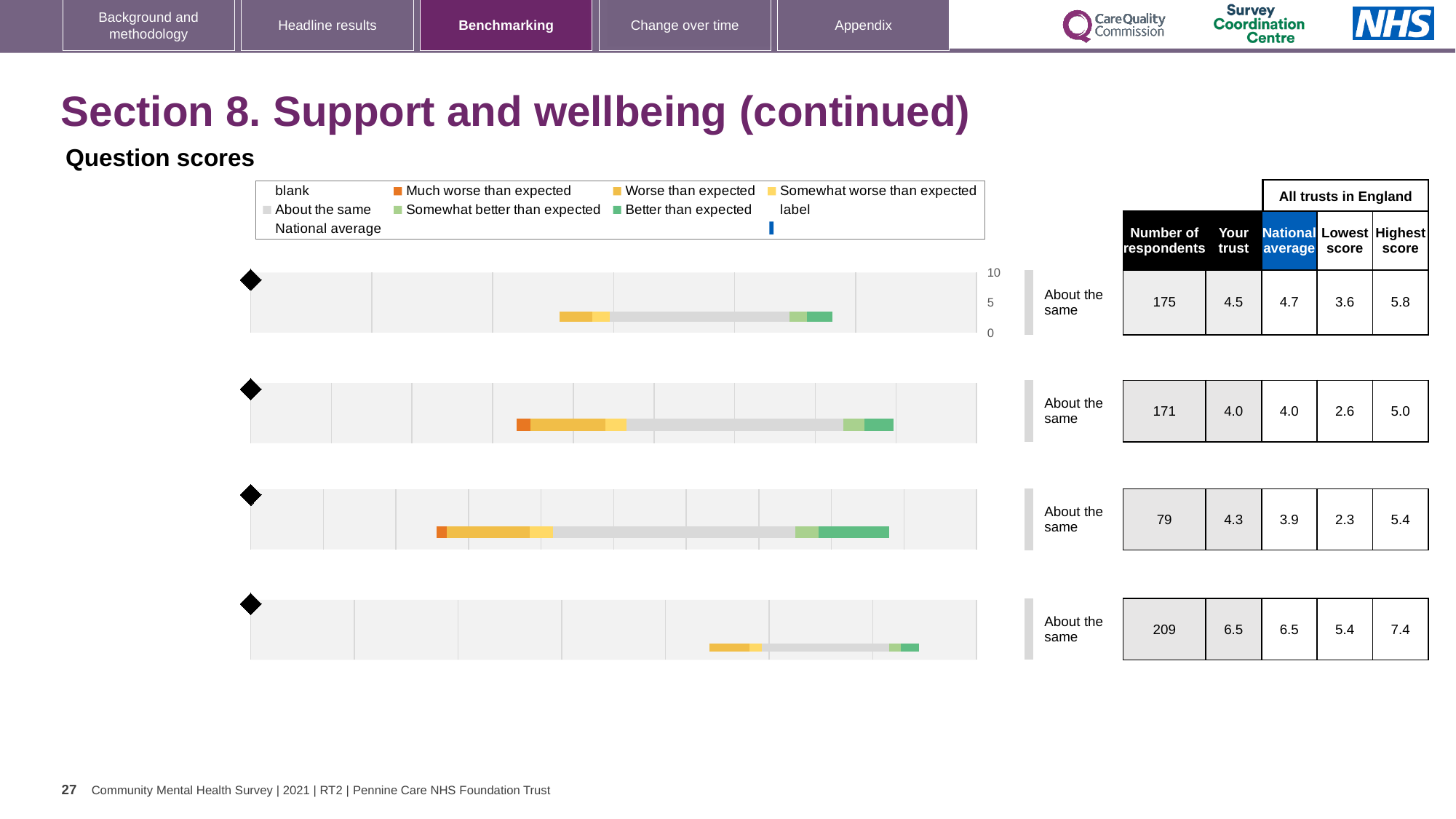
For the first (top) chart row, what is the number of respondents shown in the table? 175 How many question score charts (rows) are shown on the slide? 4 Is the 'Your trust' score for the first chart row greater or less than 5? less What is the difference in number of respondents between the fourth chart row and the third chart row? 130 Which chart row has the highest 'Your trust' score? the fourth (bottom) row, 6.5 For the fourth (bottom) chart row, what is the 'Your trust' score? 6.5 What kind of chart is used to show the question scores on this slide? bar chart For the second chart row, what is the national average score? 4.0 Which chart row has the lowest number of respondents? the third row, 79 For the first chart row, what is the difference between the highest score and the lowest score across all trusts in England? 2.2 For the third chart row, which is larger: the 'Your trust' score or the national average? Your trust (4.3) What benchmark category is shown next to each of the four charts? About the same